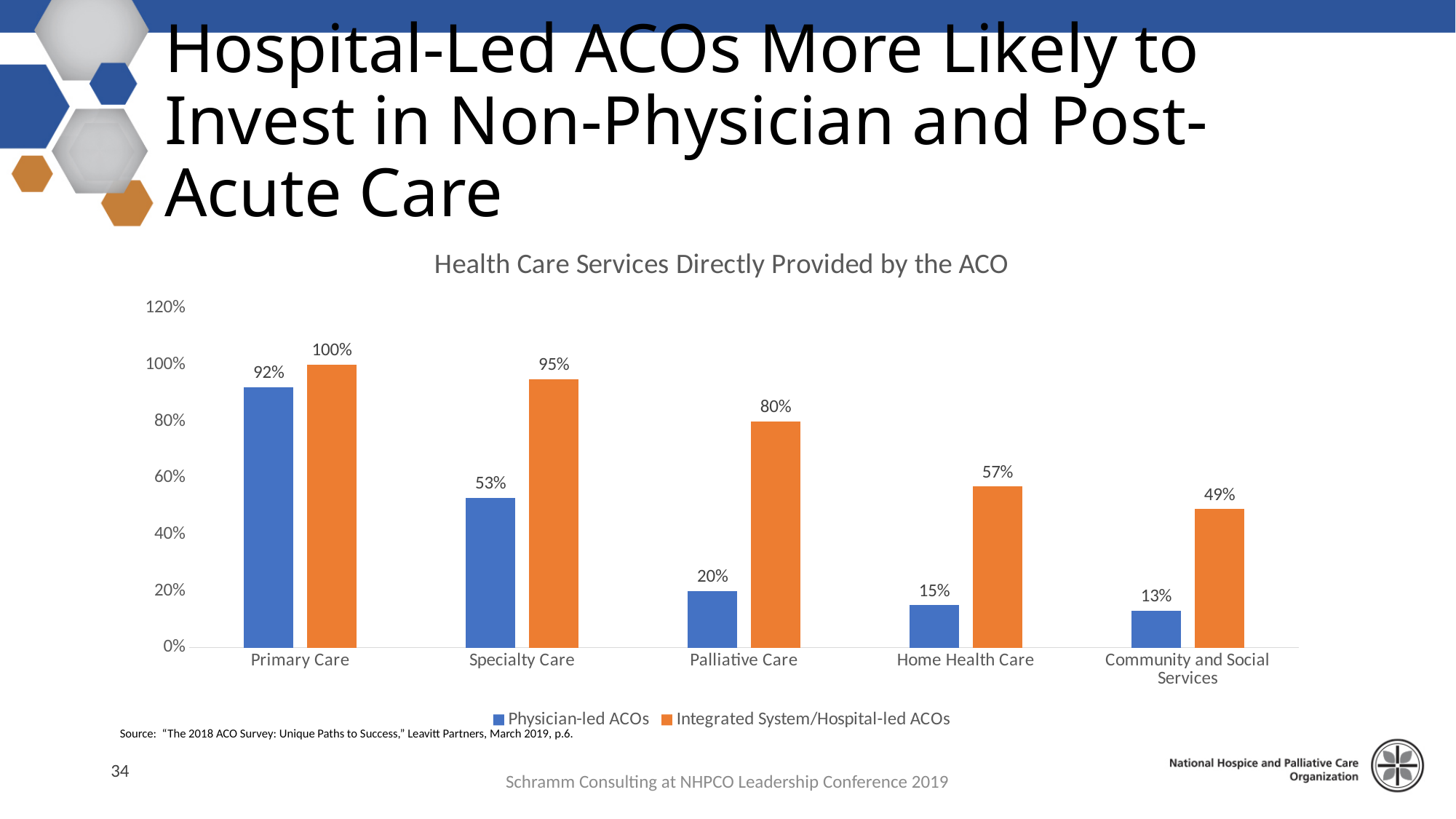
What is the title of the chart? Health Care Services Directly Provided by the ACO What is the difference between Integrated System/Hospital-led ACOs and Physician-led ACOs in Specialty Care? 42% What kind of chart is shown on the slide? Bar chart Which is larger in Home Health Care: Physician-led ACOs or Integrated System/Hospital-led ACOs? Integrated System/Hospital-led ACOs How many series does the legend list? 2 What is the value for Physician-led ACOs in Palliative Care? 20% What is the value for Physician-led ACOs in Community and Social Services? 13% How many categories are shown on the x axis? 5 Which category has the highest value for Integrated System/Hospital-led ACOs? Primary Care What is the difference between Integrated System/Hospital-led ACOs and Physician-led ACOs in Palliative Care? 60% What is the value for Integrated System/Hospital-led ACOs in Home Health Care? 57% Which category has the lowest value for Physician-led ACOs? Community and Social Services